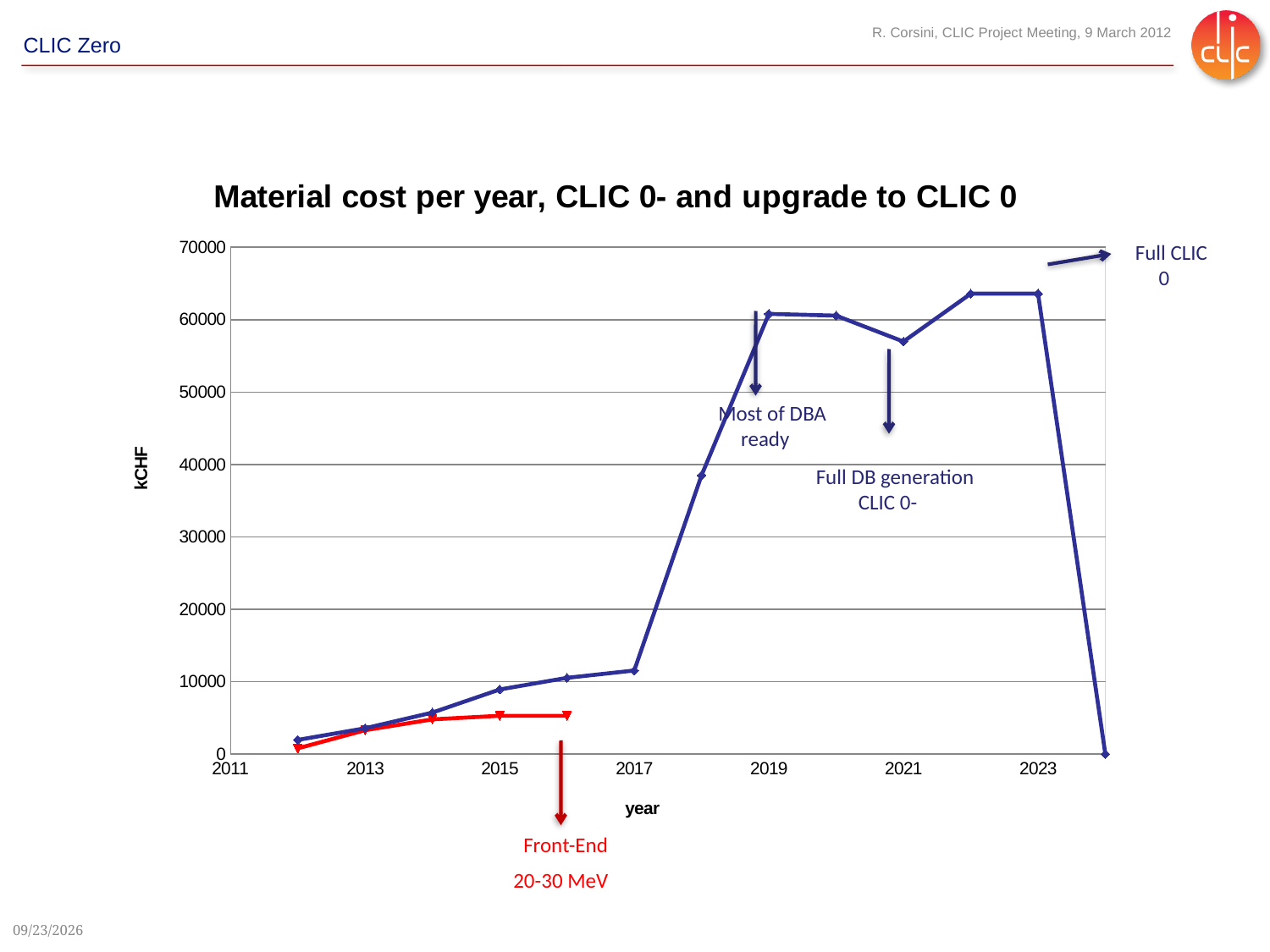
Is the value of the red line for 2016 greater or less than 10000? less Is the value of the blue line for 2015 greater or less than 10000? less Is the value of the blue line for 2021 greater or less than 60000? less What is the title of the chart? Material cost per year, CLIC 0- and upgrade to CLIC 0 What kind of chart is shown on the slide? line chart How many lines are plotted on the chart? 2 Which year has a larger value on the blue line, 2019 or 2021? 2019 Does the blue line rise or fall between 2012 and 2019? rise What is the label on the vertical axis of the chart? kCHF